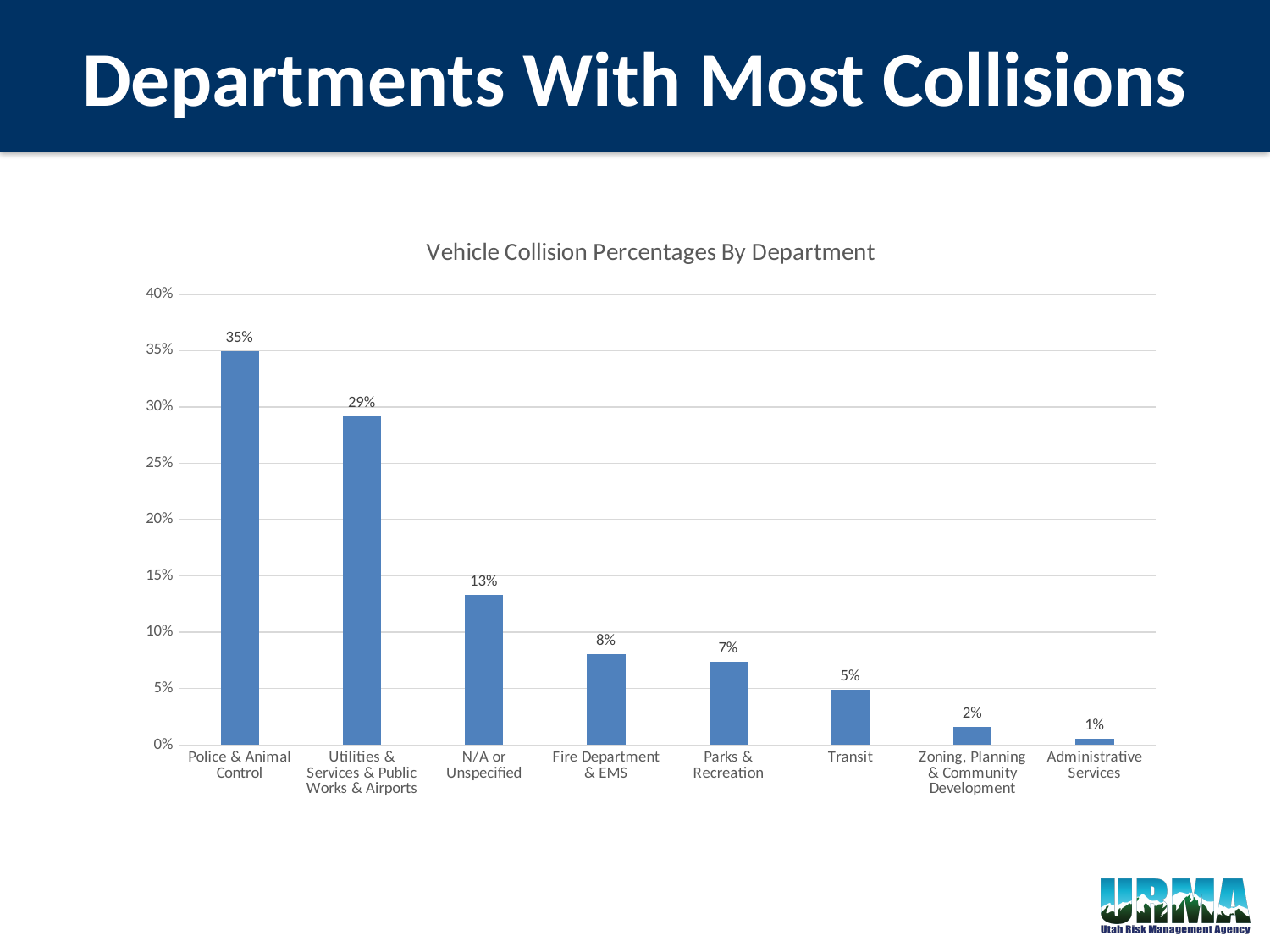
What type of chart is shown on the slide? Bar chart Do the values rise or fall from left to right across the chart? Fall Which department has the highest vehicle collision percentage? Police & Animal Control What is the vehicle collision percentage for Utilities & Services & Public Works & Airports? 29% What is the title of the chart? Vehicle Collision Percentages By Department What is the vehicle collision percentage for Police & Animal Control? 35% How many departments are shown on the chart? 8 What is the vehicle collision percentage for Transit? 5% What is the vehicle collision percentage for Fire Department & EMS? 8% Which department has the lowest vehicle collision percentage? Administrative Services What is the difference in collision percentage between Police & Animal Control and Utilities & Services & Public Works & Airports? 6% Which has a higher collision percentage, N/A or Unspecified or Parks & Recreation? N/A or Unspecified